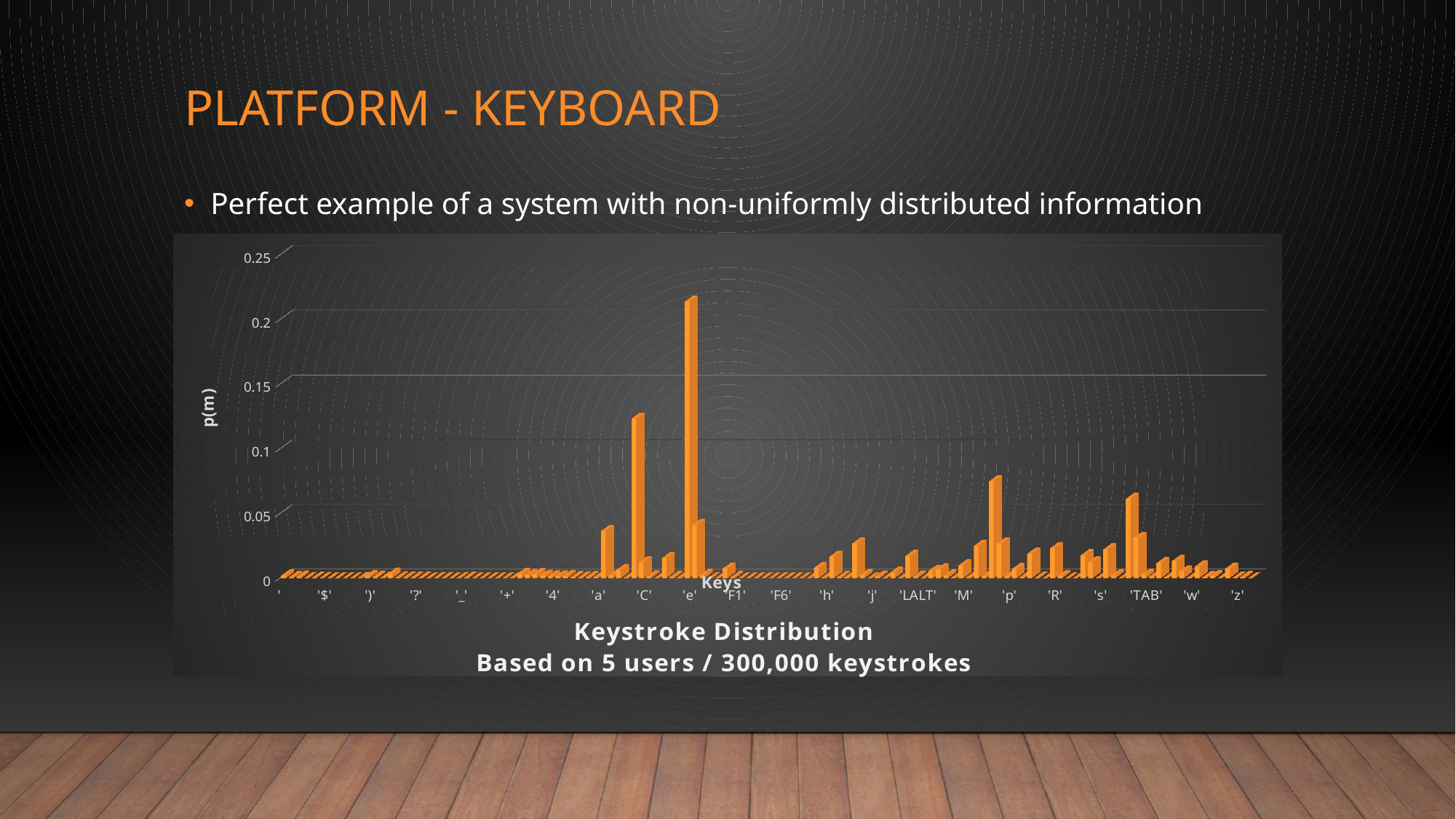
What kind of chart is shown on the slide? bar chart Is the value for 'e' greater or less than 0.15? less Which has the larger value, 'e' or '?'? 'e' Which has the larger value, 'e' or 'F6'? 'e' Is the value for '$' greater or less than 0.05? less Is the value for 'F6' greater or less than 0.05? less What is the title of the chart? Keystroke Distribution Based on 5 users / 300,000 keystrokes What is the label on the vertical axis of the chart? p(m)